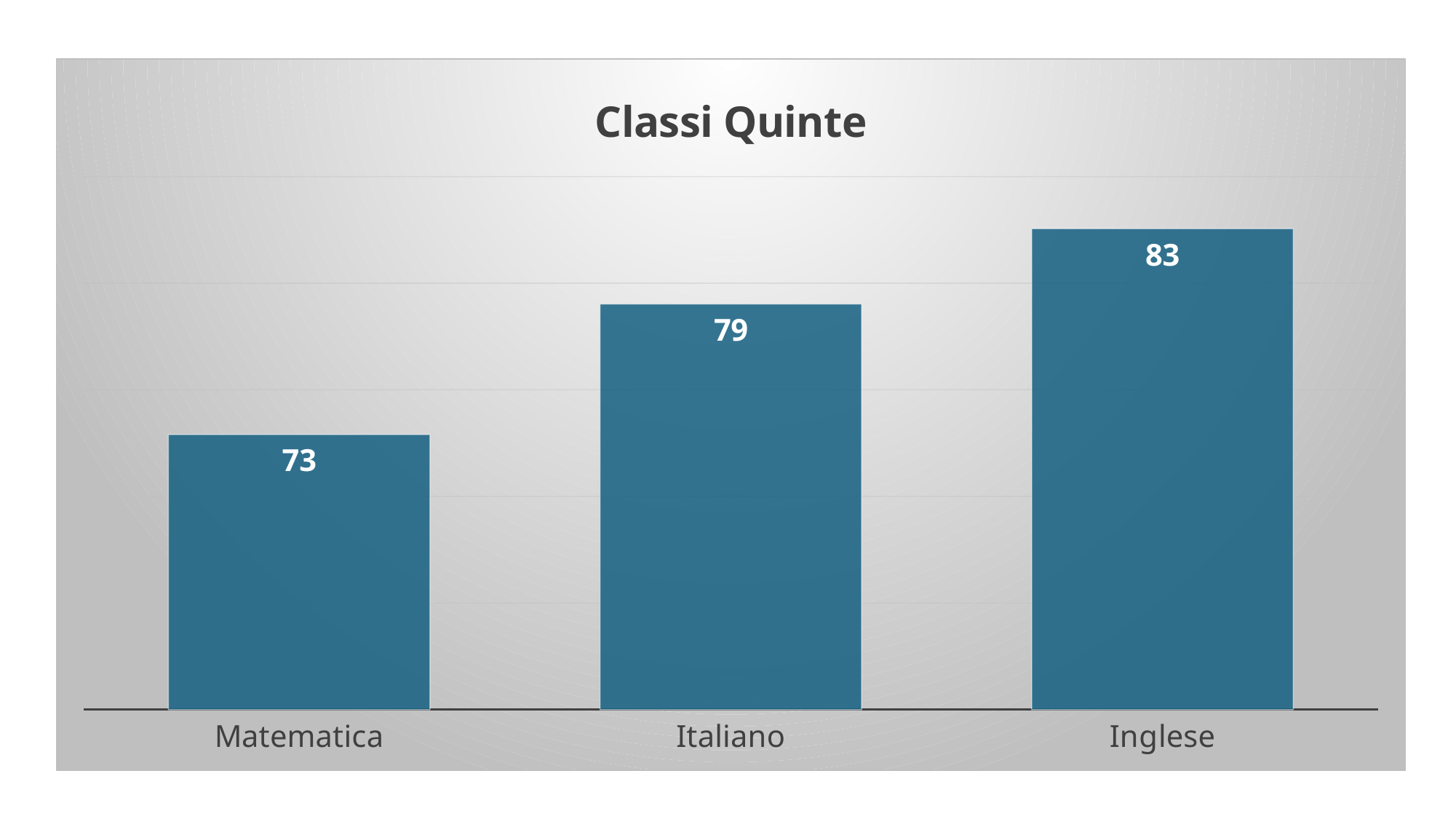
What is the title of the chart? Classi Quinte What is the difference between the values for Inglese and Matematica? 10 Which is larger, the value for Italiano or the value for Inglese? Inglese What kind of chart is shown on the slide? Bar chart What is the value for Italiano? 79 What is the value for Inglese? 83 Do the values rise or fall from left to right across the categories? Rise Which category has the lowest value? Matematica How many categories are shown on the chart? 3 What is the difference between the values for Italiano and Matematica? 6 What is the value for Matematica? 73 Which category has the highest value? Inglese